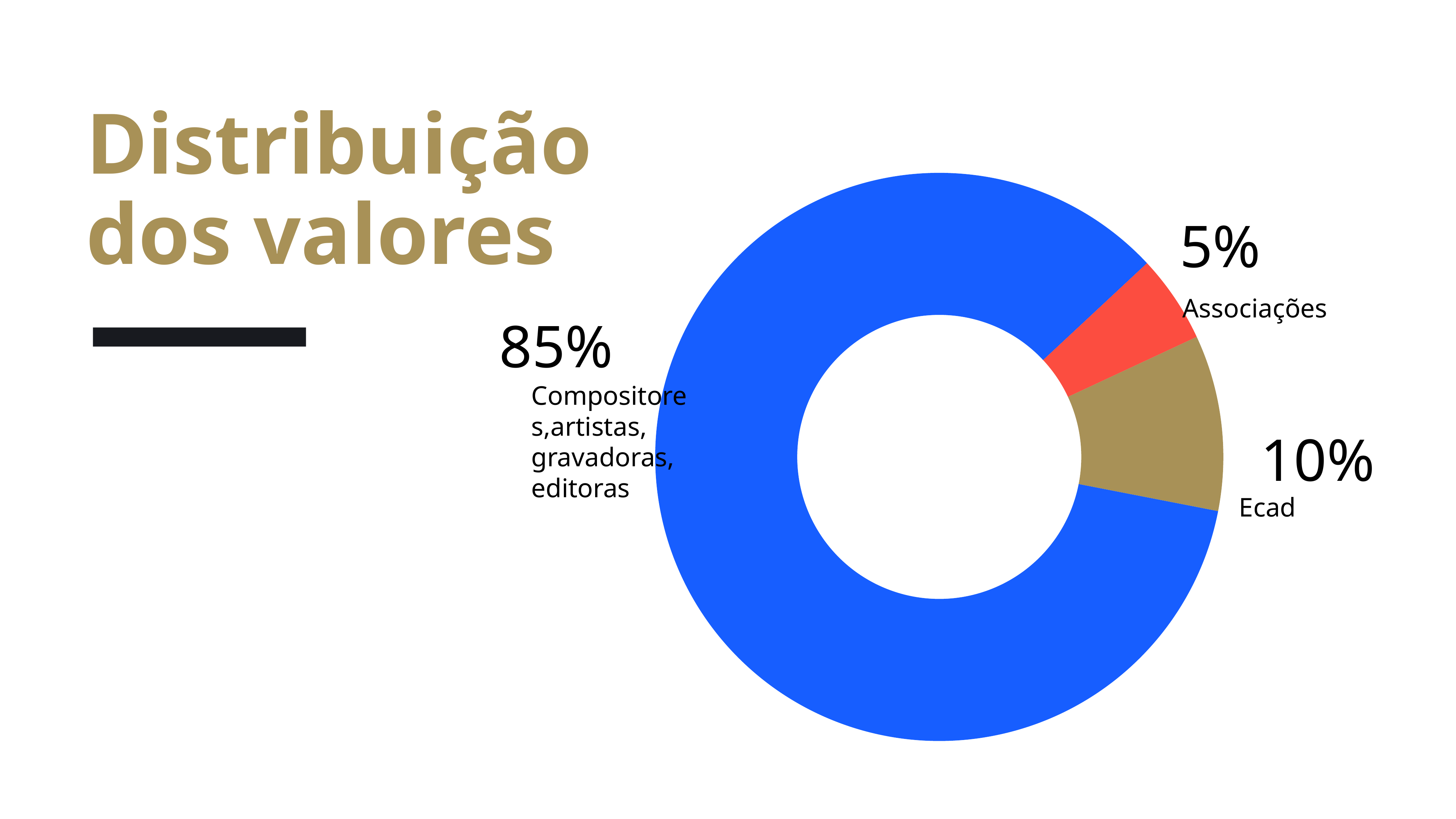
What is the difference in percentage points between the Compositores, artistas, gravadoras, editoras share and the Ecad share? 75 What is the title of the slide? Distribuição dos valores What share of the chart goes to Associações? 5% What share of the chart goes to Compositores, artistas, gravadoras, editoras? 85% What colour is the Ecad slice? Gold/tan Which is larger, the share for Ecad or the share for Associações? Ecad What kind of chart is shown on the slide? Pie chart (doughnut) Which category has the largest share? Compositores, artistas, gravadoras, editoras What share of the chart goes to Ecad? 10% What is the difference in percentage points between the Ecad share and the Associações share? 5 How many categories does the chart show? 3 Which category has the smallest share? Associações